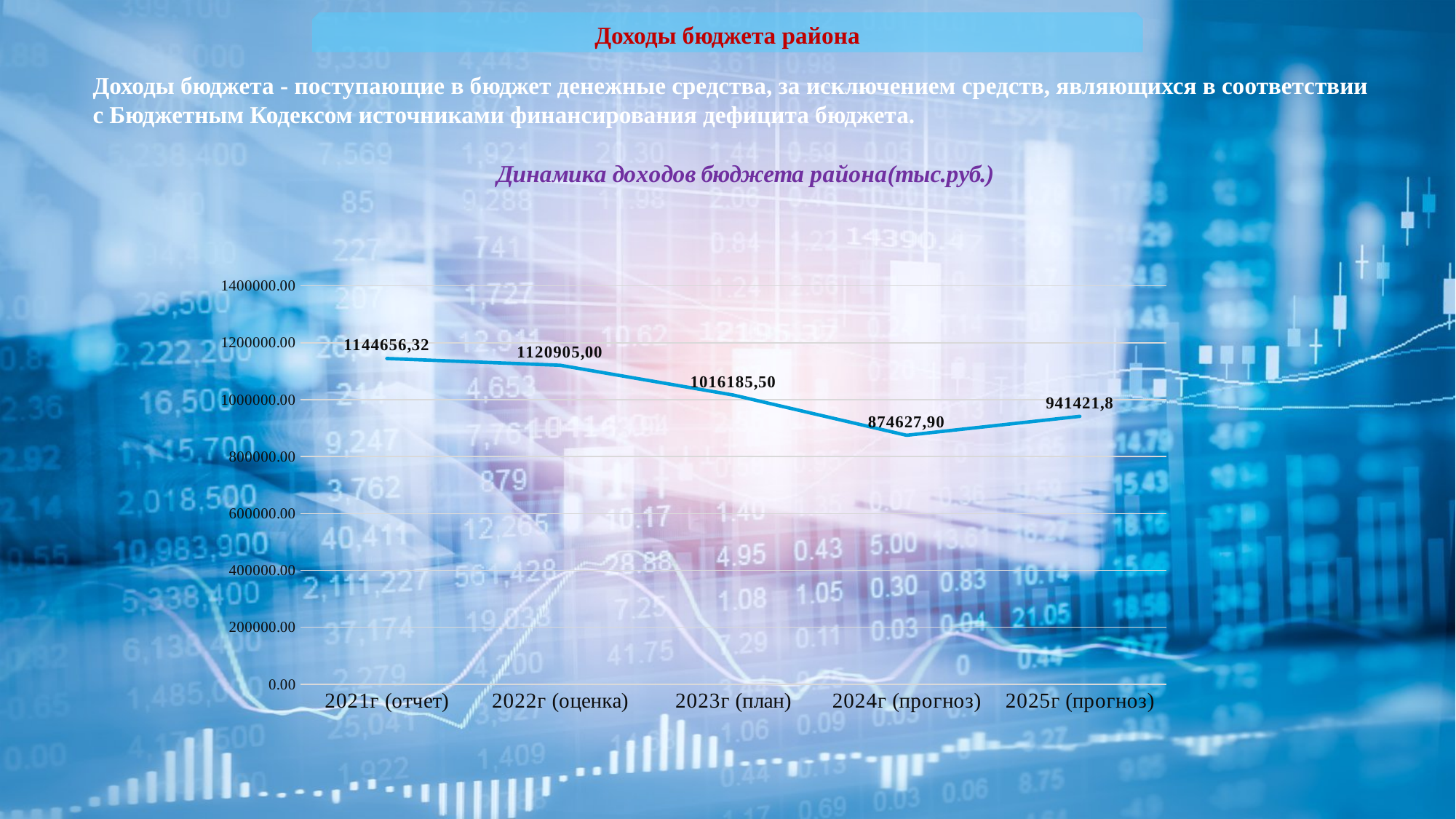
What is the difference between the values for 2023г (план) and 2024г (прогноз)? 141557,60 What is the value for 2023г (план)? 1016185,50 Is the value for 2024г (прогноз) greater or less than 1000000.00? less Which category has the highest value? 2021г (отчет) What is the title of the chart? Динамика доходов бюджета района(тыс.руб.) What is the value for 2021г (отчет)? 1144656,32 Which is larger, the value for 2024г (прогноз) or the value for 2025г (прогноз)? 2025г (прогноз) What kind of chart is shown on the slide? line chart What is the value for 2025г (прогноз)? 941421,8 Which category has the lowest value? 2024г (прогноз) How many categories are plotted on the x axis? 5 What is the difference between the values for 2021г (отчет) and 2022г (оценка)? 23751,32